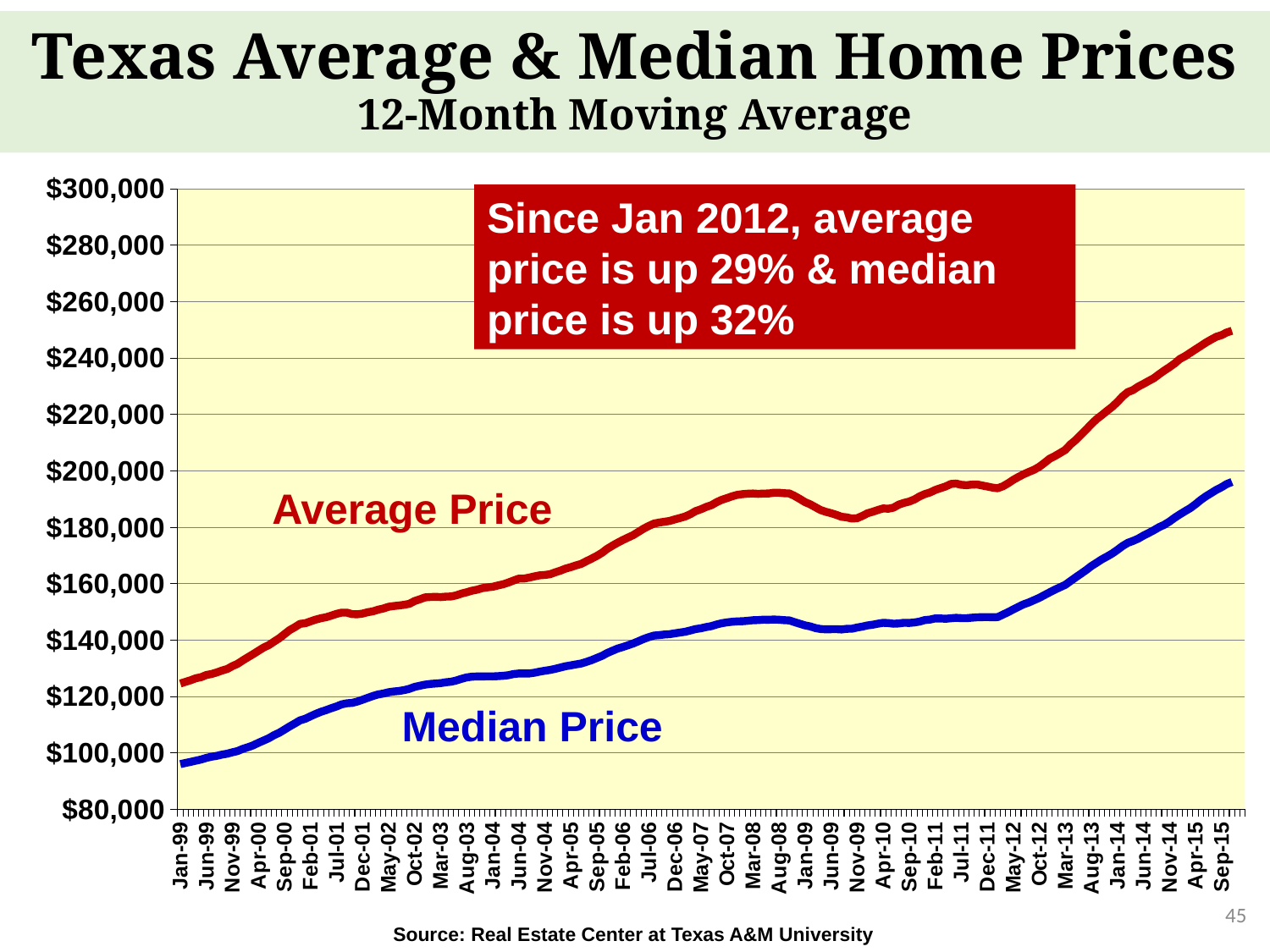
Is the Median Price at Dec-11 greater or less than $160,000? less Does the Average Price rise or fall between Mar-08 and Nov-09? Fall Is the Average Price at Sep-15 greater or less than $220,000? greater Is the Median Price at Jan-99 greater or less than $100,000? less What colour is the Median Price line? Blue How many series are plotted on the chart? 2 Does the Median Price generally rise or fall from Jan-99 to Sep-15? Rise What kind of chart is shown on the slide? Line chart Which series has the higher value at Sep-15, Average Price or Median Price? Average Price What are the names of the two series plotted on the chart? Average Price and Median Price